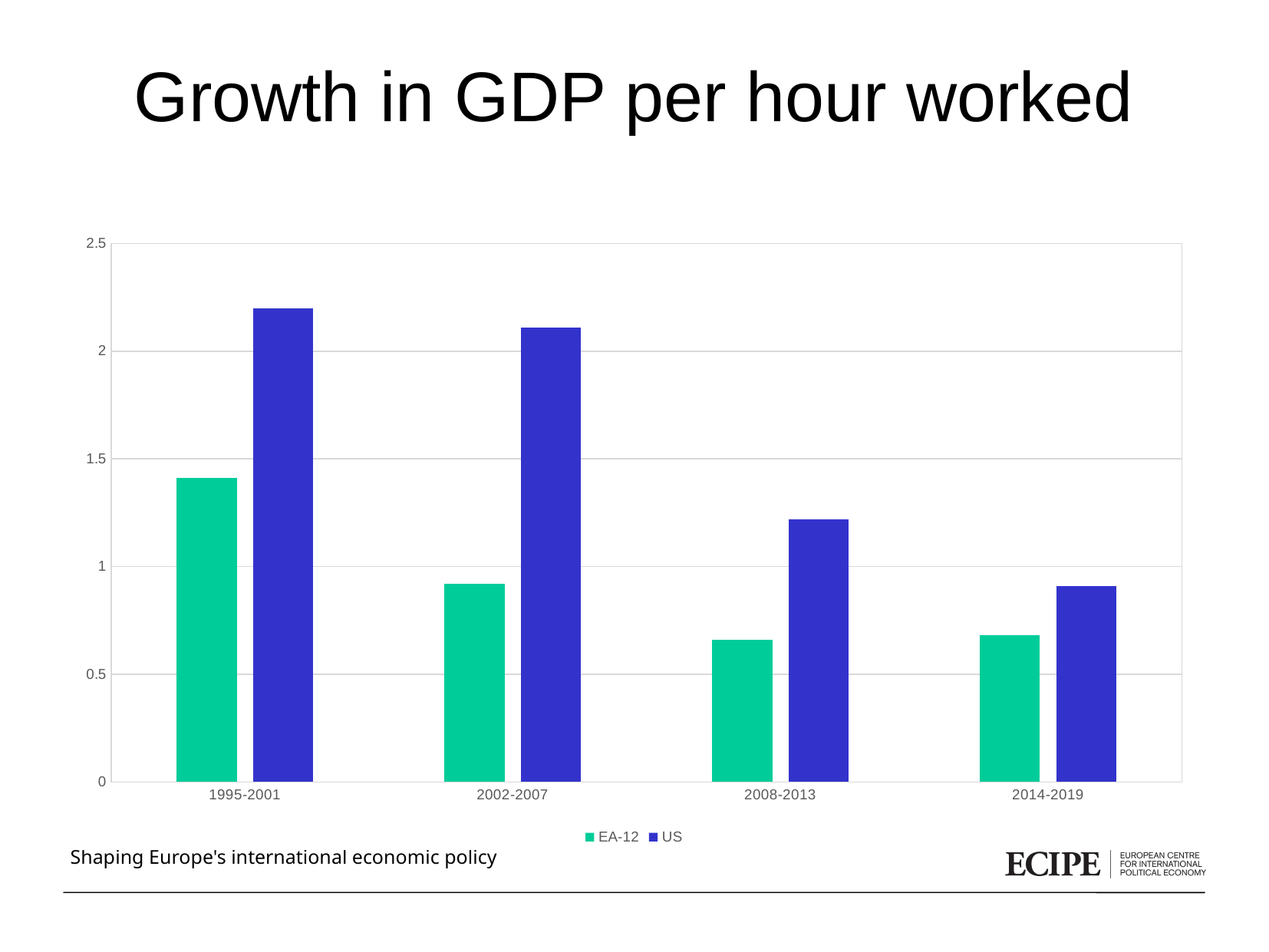
In 2008-2013, which is larger, the EA-12 value or the US value? US Is the value for US in 2014-2019 greater or less than 1? less How many series does the legend list? 2 Is the value for US in 1995-2001 greater or less than 2? greater Is the value for EA-12 in 1995-2001 greater or less than 1? greater In which period is the EA-12 value highest? 1995-2001 In which period is the US value lowest? 2014-2019 How many time periods are shown on the x axis? 4 What kind of chart is shown on the slide? Bar chart What is the title of the chart? Growth in GDP per hour worked Which series is listed first in the legend? EA-12